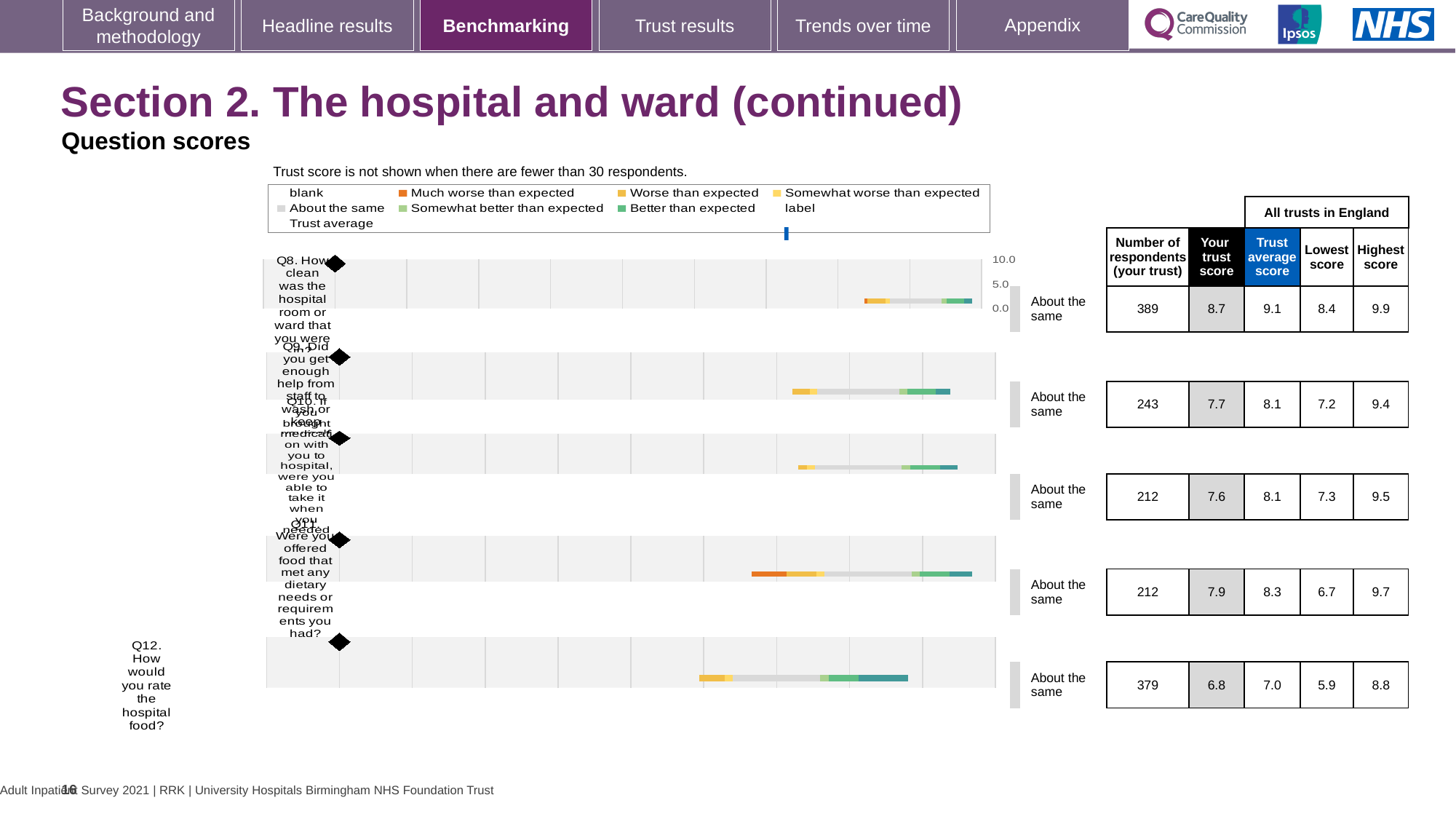
What is 'Your trust score' for Q12, 'How would you rate the hospital food?' 6.8 What is the 'Highest score' across all trusts in England for Q10 (medication brought with you to hospital)? 9.5 Which question has the highest 'Your trust score'? Q8 (8.7) For Q8, how much higher is the trust average score than your trust score? 0.4 For Q11 (food that met dietary needs), what is the difference between the highest score and the lowest score across all trusts in England? 3.0 For Q9 (enough help from staff to wash or keep clean), is your trust score higher or lower than the trust average score? lower What benchmark category is shown next to every question on this slide? About the same Which question has the lowest 'Trust average score'? Q12 (7.0) What is the 'Lowest score' across all trusts in England for Q12, 'How would you rate the hospital food?' 5.9 How many respondents (your trust) are shown for Q8, 'How clean was the hospital room or ward that you were in?' 389 How many questions (Q8 to Q12) are plotted on the chart? 5 What kind of chart is used to show the question scores? bar chart